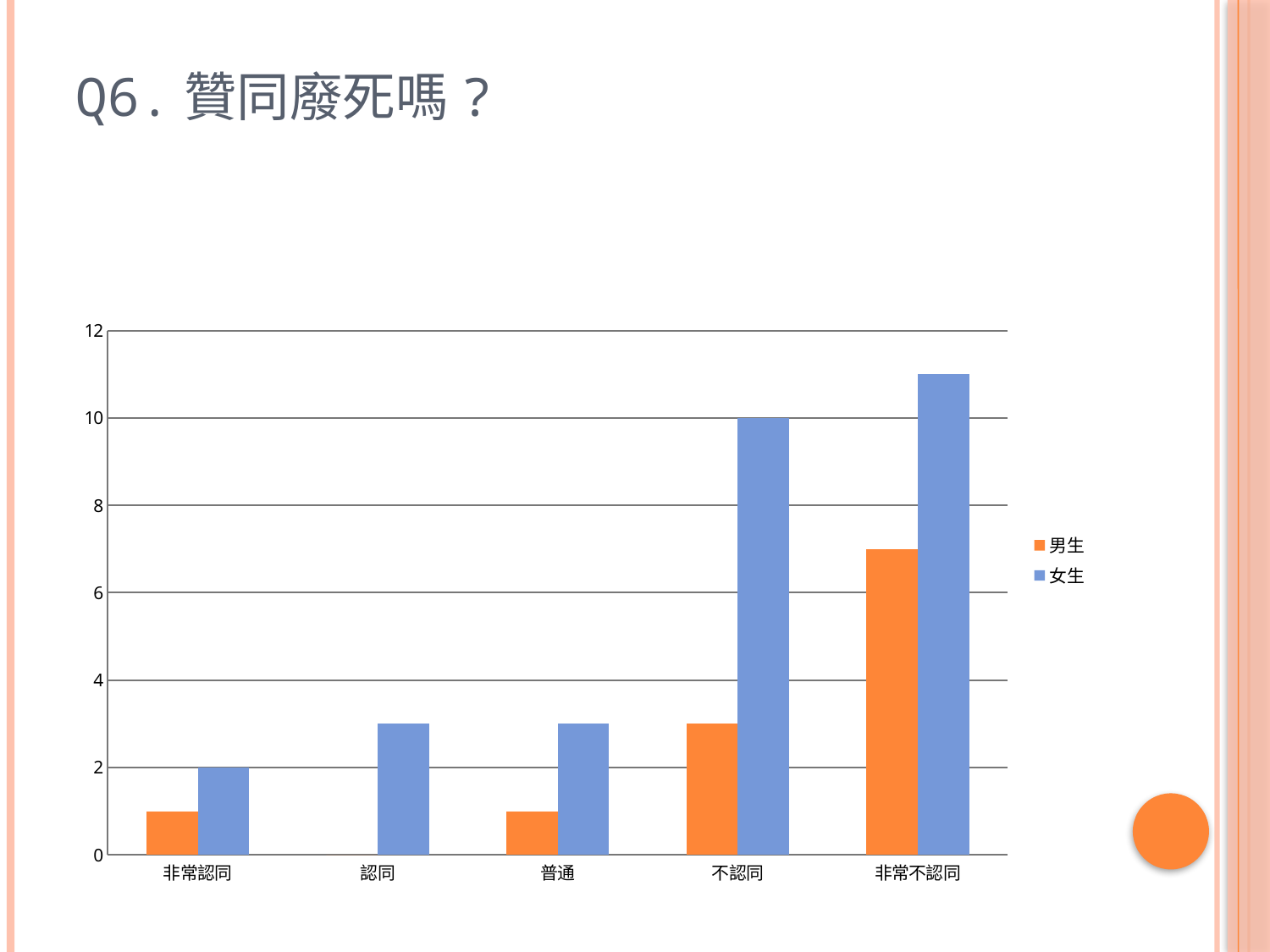
Is the value for 女生 in the 普通 category greater or less than 4? less How many categories are shown on the x axis? 5 Which category has the lowest value for 男生? 認同 What type of chart is shown on the slide? bar chart Which colour represents the 男生 series? orange Which category has the highest value for 男生? 非常不認同 Is the value for 男生 in the 非常不認同 category greater or less than 6? greater In the 不認同 category, which series has the larger value, 男生 or 女生? 女生 How many series does the legend list? 2 What is the value for 女生 in the 不認同 category? 10 Which category has the highest value for 女生? 非常不認同 What is the value for 女生 in the 非常認同 category? 2